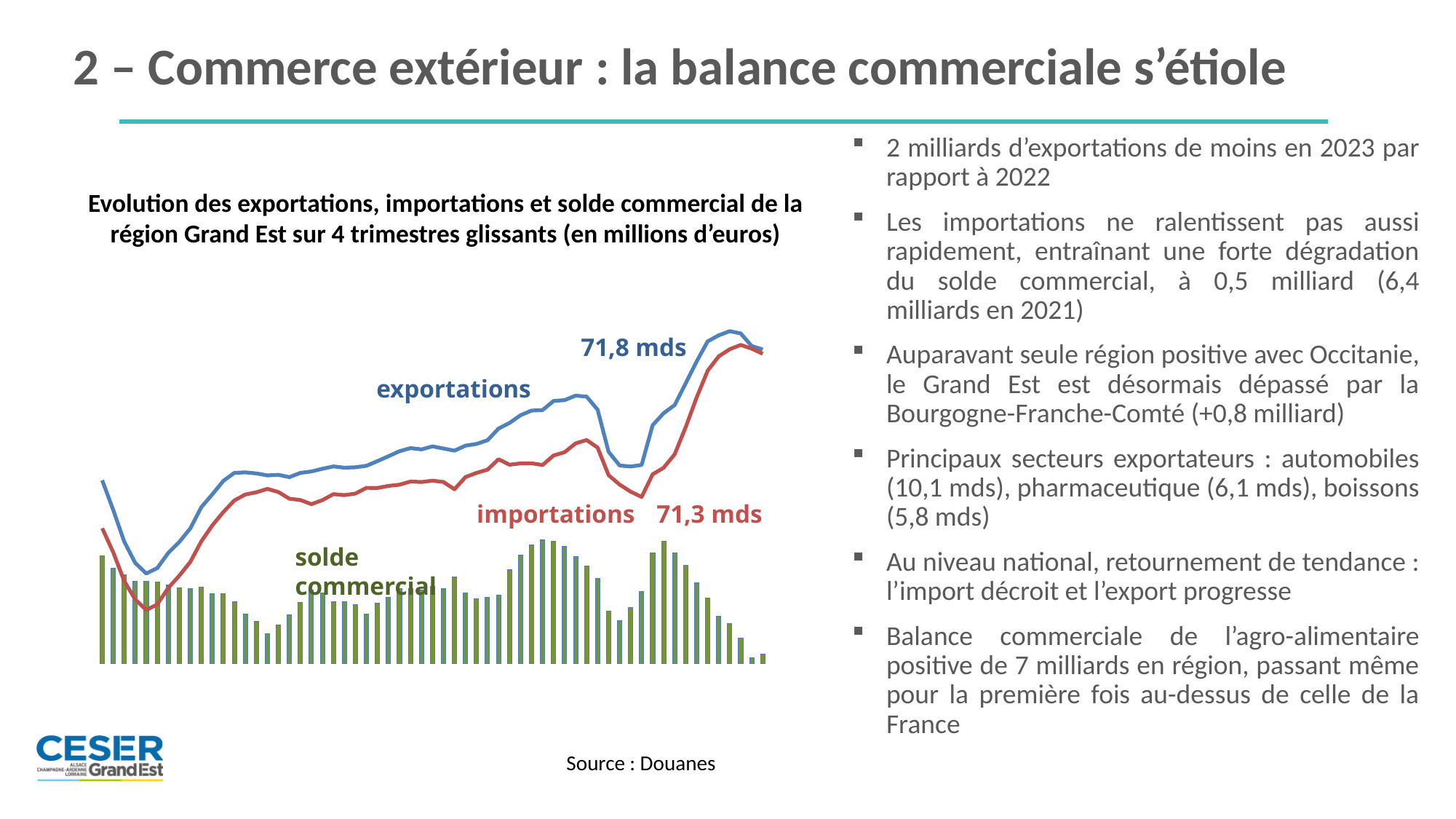
What colour is the importations line? red What is the final value shown for importations on the chart? 71,3 mds How many data series are plotted on the chart? 3 What is the final value shown for exportations on the chart? 71,8 mds How is the solde commercial series drawn on the chart: as a line or as bars? bars What is the difference between the final exportations value (71,8 mds) and the final importations value (71,3 mds)? 0,5 mds Overall, does the exportations line end higher or lower than it starts? higher What is the source given below the chart? Douanes At the right end of the chart, which is larger: exportations or importations? exportations Do the solde commercial bars rise or fall over the last part of the chart (towards the right end)? fall How is the exportations series drawn on the chart: as a line or as bars? line